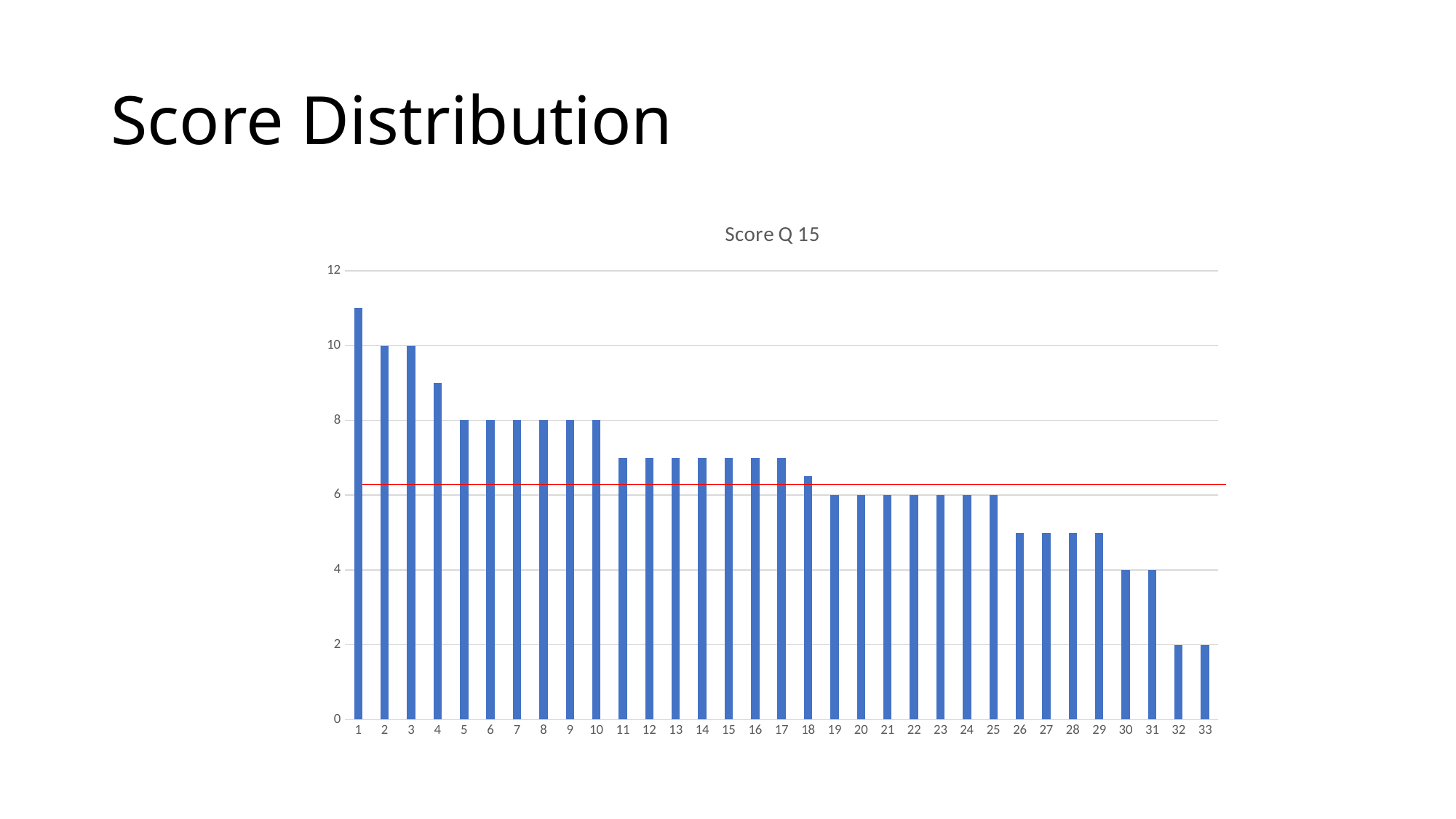
What is the title of the chart? Score Q 15 Is the value for category 1 greater or less than 10? greater What is the value for category 2? 10 Is the value for category 14 greater or less than 8? less How many bars are plotted in the chart? 33 Do the values rise or fall from left to right along the x axis? fall What kind of chart is shown on the slide? bar chart What is the value for category 22? 6 What is the value for category 7? 8 What is the difference between the values for category 3 and category 32? 8 Which category has the highest value? 1 What is the value for category 33? 2